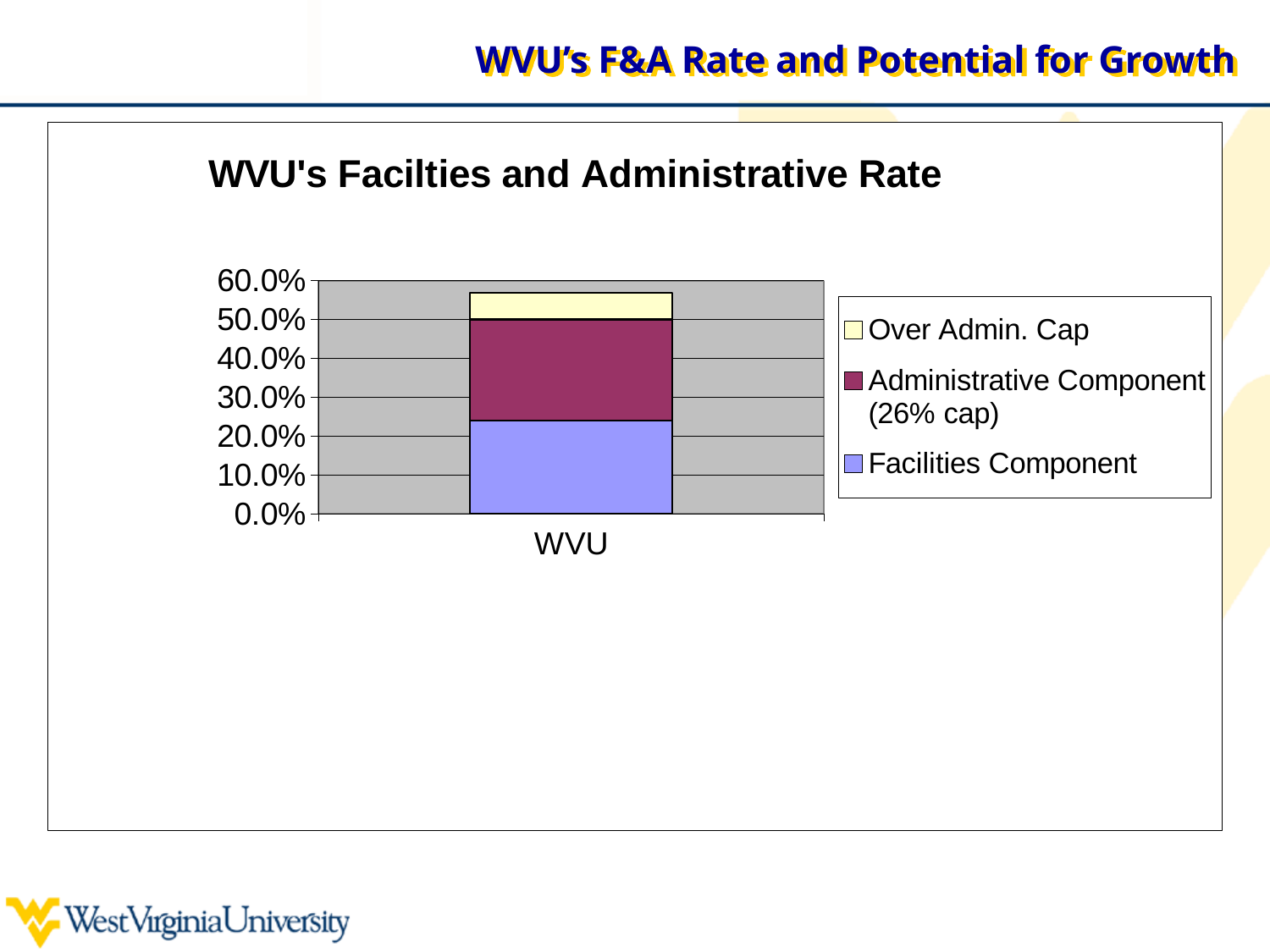
Which series is shown at the bottom of the stacked bar? Facilities Component Is the Facilities Component value for WVU greater or less than 30.0%? less How many series does the legend list? 3 How many categories are shown on the x axis? 1 Is the total height of the stacked bar for WVU greater or less than 50.0%? greater Which series is the smallest segment of the WVU bar? Over Admin. Cap Is the total height of the stacked bar for WVU greater or less than 60.0%? less What is the title of the chart? WVU's Facilties and Administrative Rate What is the label of the category on the x axis? WVU What kind of chart is shown on the slide? stacked bar chart Is the Over Admin. Cap segment larger or smaller than the Administrative Component (26% cap) segment? smaller